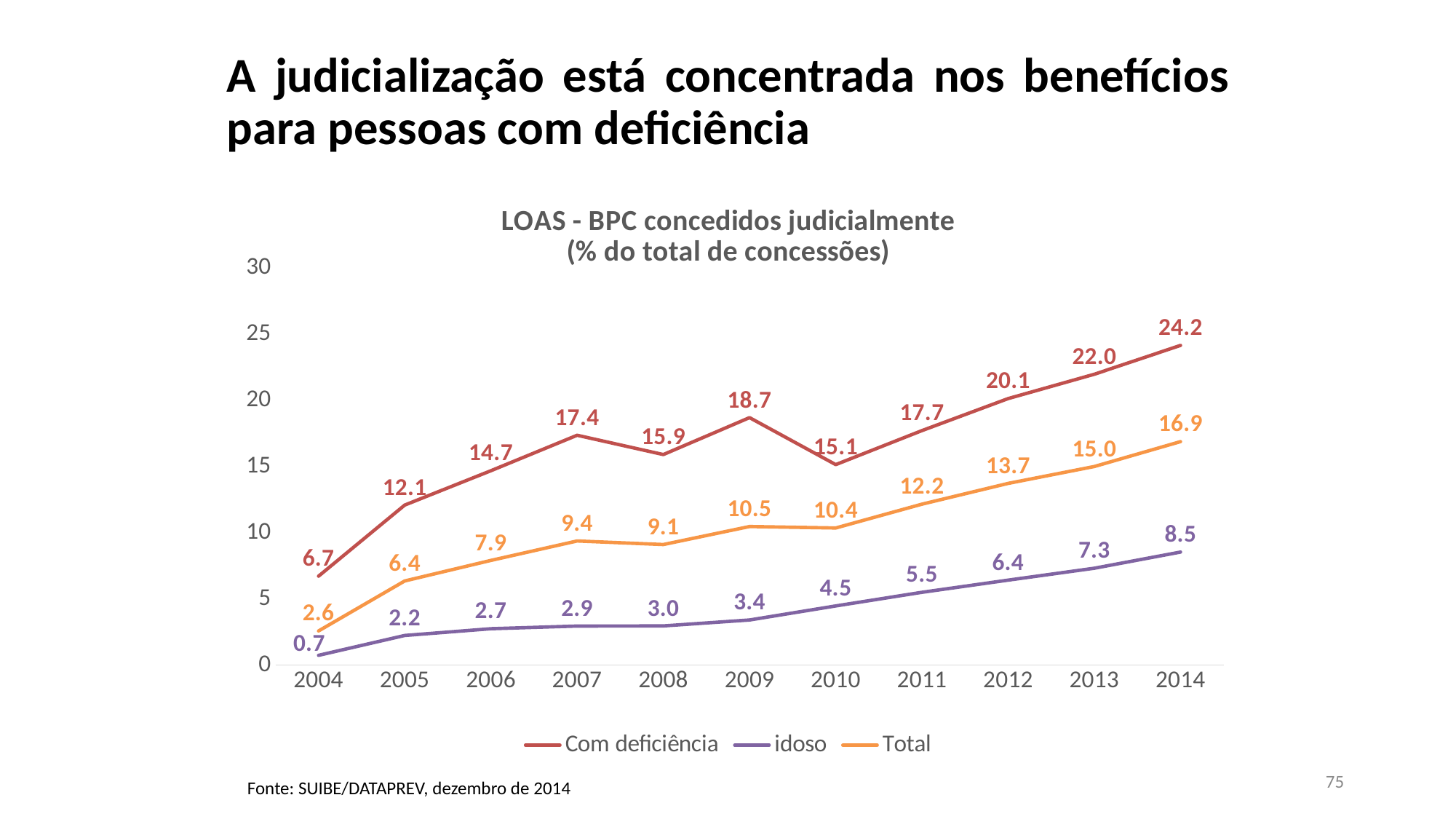
What is the title of the chart? LOAS - BPC concedidos judicialmente (% do total de concessões) In which year is the Total series at its highest? 2014 What is the difference between Com deficiência and idoso in 2014? 15.7 Does the idoso series rise or fall from 2004 to 2014? Rise What is the value for idoso in 2004? 0.7 What kind of chart is shown? Line chart Which is larger in 2009: Com deficiência or Total? Com deficiência What is the value for Total in 2010? 10.4 In which year is the Com deficiência series at its lowest? 2004 What is the value for Com deficiência in 2014? 24.2 How many series does the legend list? 3 How many years are shown on the x axis? 11